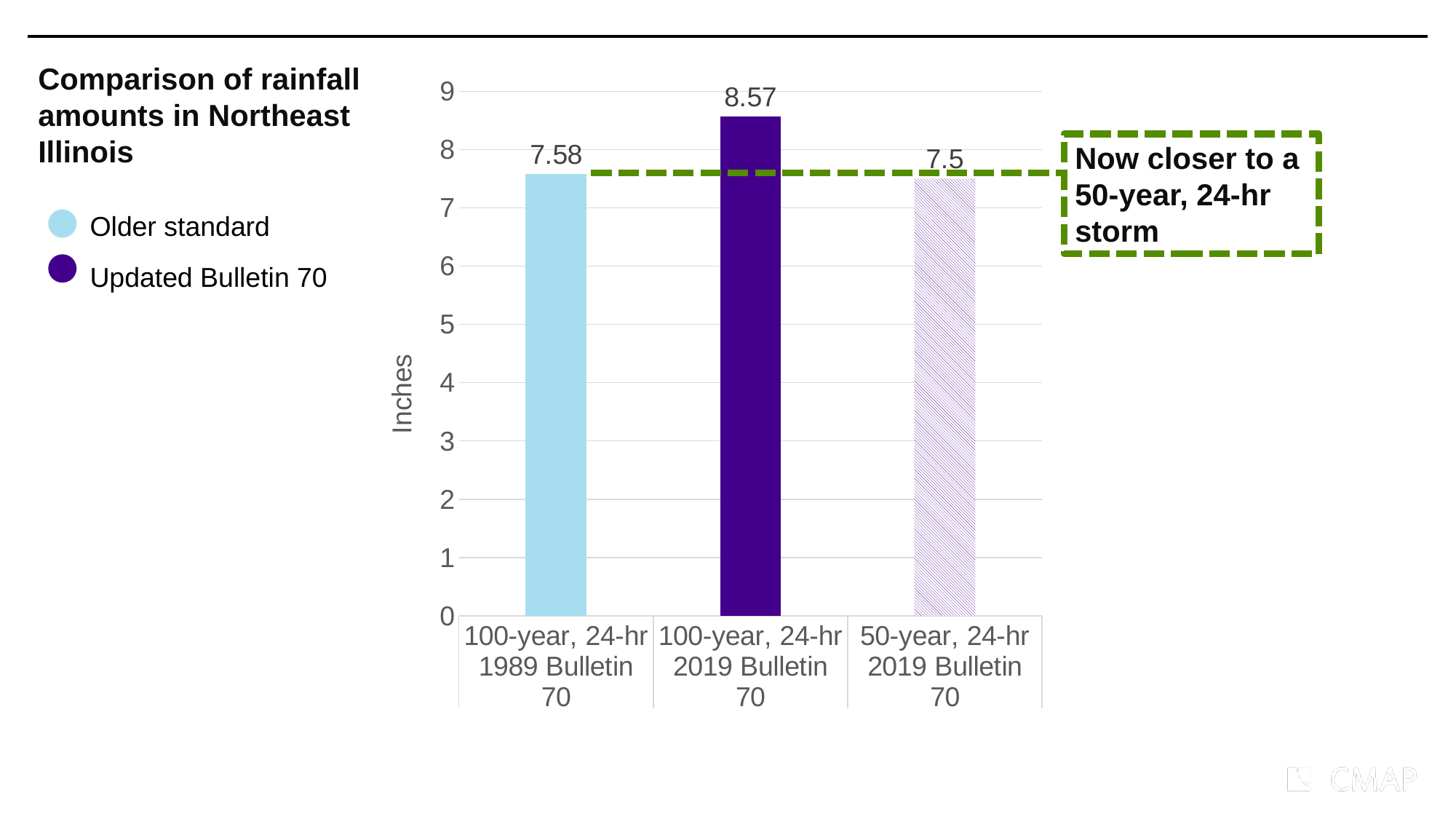
Is the value for the 100-year, 24-hr 2019 Bulletin 70 storm greater or less than 8? greater What is the rainfall amount for the 100-year, 24-hr 2019 Bulletin 70 storm? 8.57 What kind of chart is shown on the slide? Bar chart What is the label of the y axis? Inches Which is larger: the 100-year, 24-hr 1989 Bulletin 70 value or the 100-year, 24-hr 2019 Bulletin 70 value? 100-year, 24-hr 2019 Bulletin 70 What is the rainfall amount for the 100-year, 24-hr 1989 Bulletin 70 storm? 7.58 What is the difference in inches between the 100-year, 24-hr 2019 Bulletin 70 value and the 100-year, 24-hr 1989 Bulletin 70 value? 0.99 What is the rainfall amount for the 50-year, 24-hr 2019 Bulletin 70 storm? 7.5 What is the difference in inches between the 100-year, 24-hr 1989 Bulletin 70 value and the 50-year, 24-hr 2019 Bulletin 70 value? 0.08 Which category has the highest rainfall amount? 100-year, 24-hr 2019 Bulletin 70 How many categories are shown on the x axis? 3 Which category has the lowest rainfall amount? 50-year, 24-hr 2019 Bulletin 70